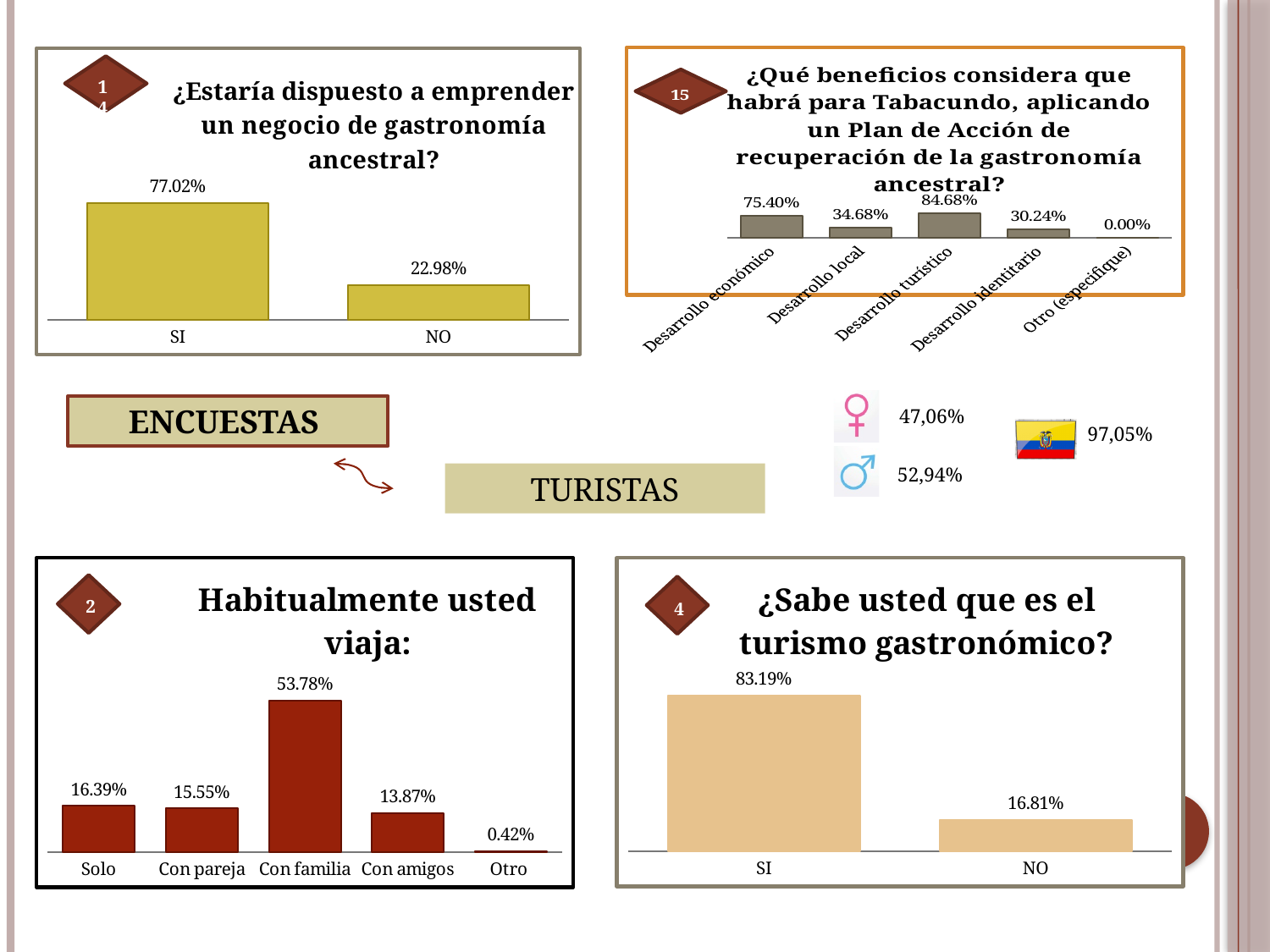
In the chart 'Habitualmente usted viaja:', which category has the lowest value? Otro In the chart '¿Qué beneficios considera que habrá para Tabacundo...?', which category has the highest value? Desarrollo turístico In the chart 'Habitualmente usted viaja:', what is the value for Con familia? 53.78% In the chart '¿Estaría dispuesto a emprender un negocio de gastronomía ancestral?', what is the value for SI? 77.02% In the chart '¿Qué beneficios considera que habrá para Tabacundo...?', how many categories are shown? 5 In the chart '¿Estaría dispuesto a emprender un negocio de gastronomía ancestral?', what is the difference between the SI and NO values? 54.04% In the chart '¿Qué beneficios considera que habrá para Tabacundo...?', what is the value for Desarrollo local? 34.68% In the chart '¿Sabe usted que es el turismo gastronómico?', what is the value for NO? 16.81% In the chart '¿Qué beneficios considera que habrá para Tabacundo...?', which is larger: Desarrollo económico or Desarrollo identitario? Desarrollo económico In the chart 'Habitualmente usted viaja:', what is the difference between Solo and Con pareja? 0.84% What type of chart is '¿Sabe usted que es el turismo gastronómico?'? Bar chart In the chart '¿Sabe usted que es el turismo gastronómico?', which is larger: SI or NO? SI